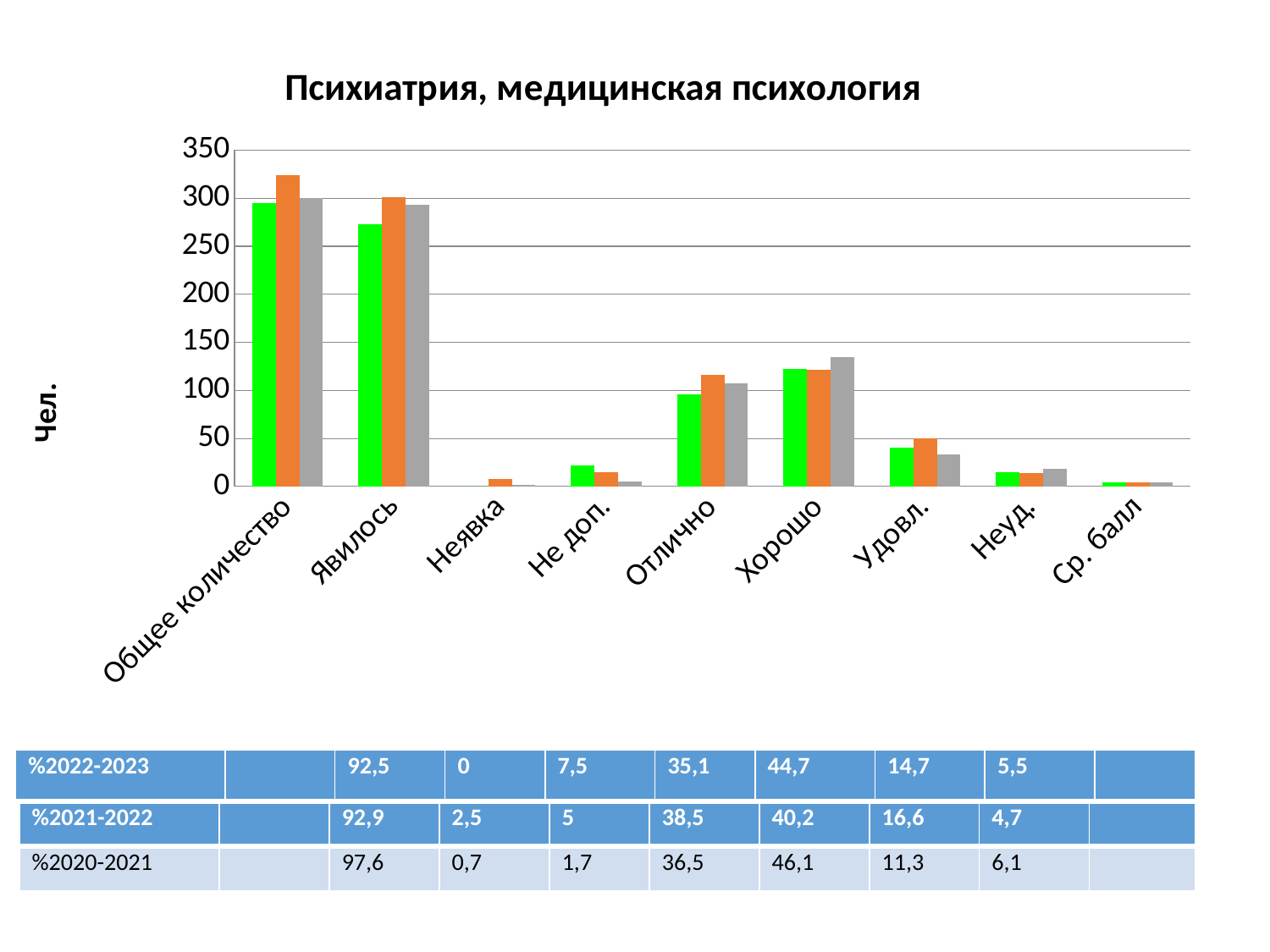
Is the green bar for "Явилось" greater or less than 250? greater Which category has the tallest bars in the chart? Общее количество What is the label on the vertical axis of the chart? Чел. Is the orange bar for "Общее количество" greater or less than 300? greater What is the title of the chart? Психиатрия, медицинская психология For "Общее количество", which bar is taller, the green one or the orange one? the orange one What kind of chart is shown on the slide? bar chart Is the gray bar for "Хорошо" greater or less than 100? greater For "Удовл.", which bar is taller, the orange one or the gray one? the orange one How many categories are shown along the x axis of the chart? 9 For "Хорошо", which bar is taller, the green one or the gray one? the gray one